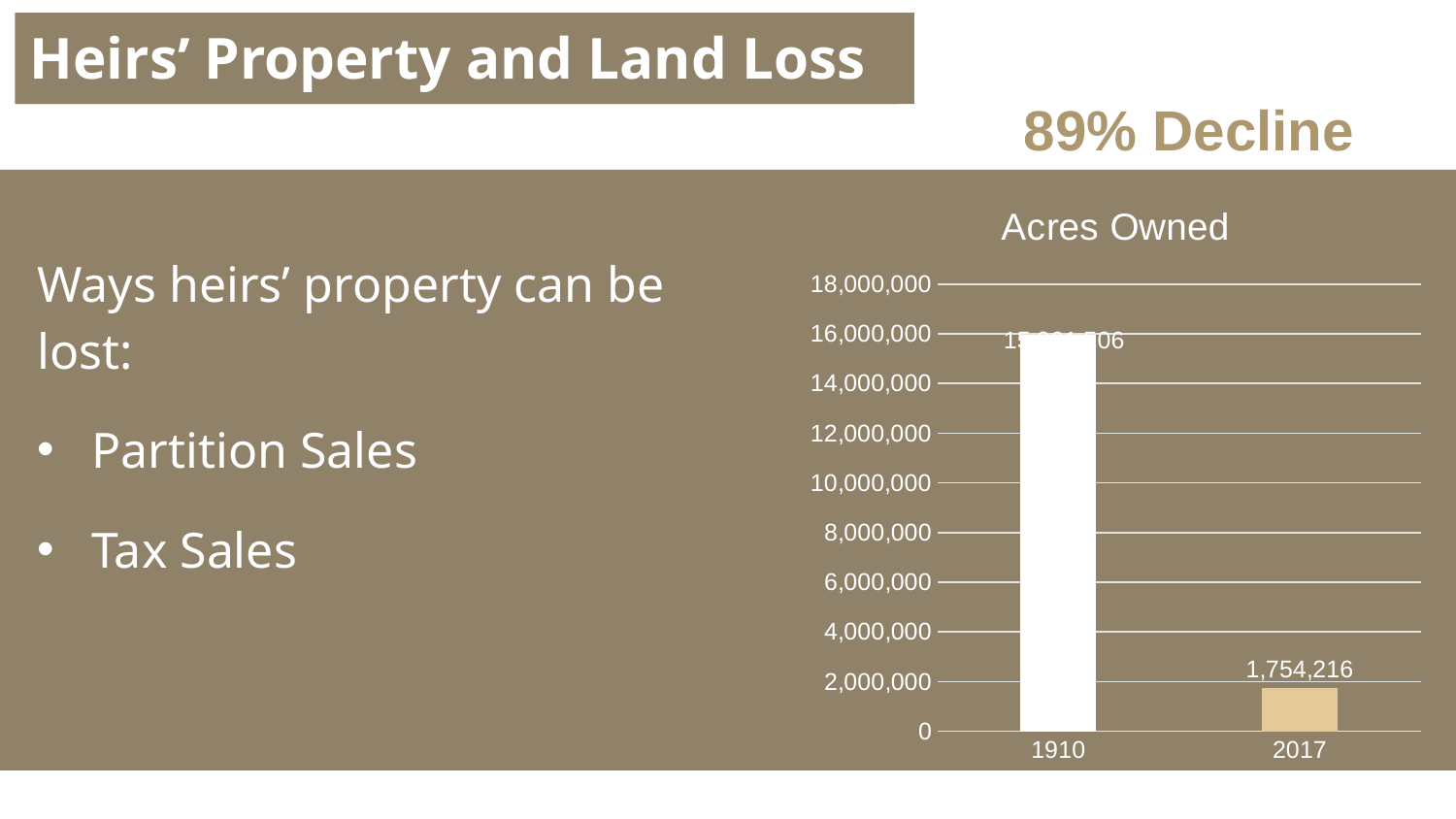
What is the value for 2017 in the Acres Owned chart? 1,754,216 What is the highest value shown on the vertical axis of the Acres Owned chart? 18,000,000 Which year has the highest value in the Acres Owned chart? 1910 Which year has the lowest value in the Acres Owned chart? 2017 How many categories (years) are plotted in the Acres Owned chart? 2 Is the value for 2017 in the Acres Owned chart greater or less than 2,000,000? less What is the title of the chart? Acres Owned What kind of chart is shown on the slide? bar chart Do the values in the Acres Owned chart rise or fall from 1910 to 2017? fall Which is larger in the Acres Owned chart, the value for 1910 or the value for 2017? 1910 Is the value for 1910 in the Acres Owned chart greater or less than 14,000,000? greater